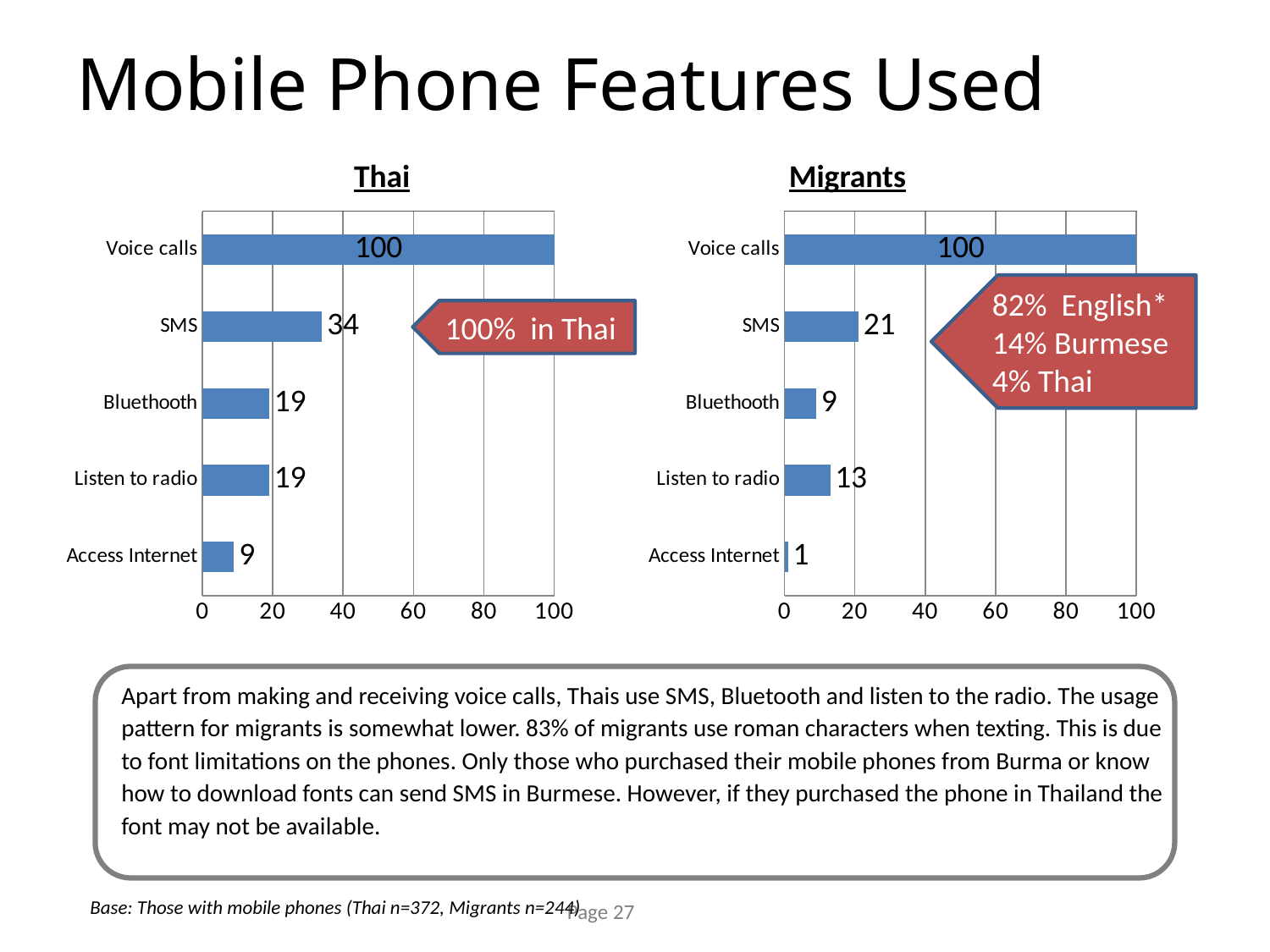
In the Migrants chart, is the value for SMS greater or less than 40? less In the Migrants chart, what is the value for Listen to radio? 13 In the Migrants chart, which category has the highest value? Voice calls What type of chart is the Migrants chart? bar chart What is the title of the chart on the left? Thai Which is larger in the Thai chart: Bluetooth or Access Internet? Bluetooth How many categories are shown in the Thai chart? 5 What is the difference between the SMS values in the Thai chart and the Migrants chart? 13 In the Thai chart, which category has the lowest value? Access Internet In the Migrants chart, what is the value for Access Internet? 1 In the Thai chart, what is the value for SMS? 34 In the Migrants chart, what is the difference between Listen to radio and Bluetooth? 4